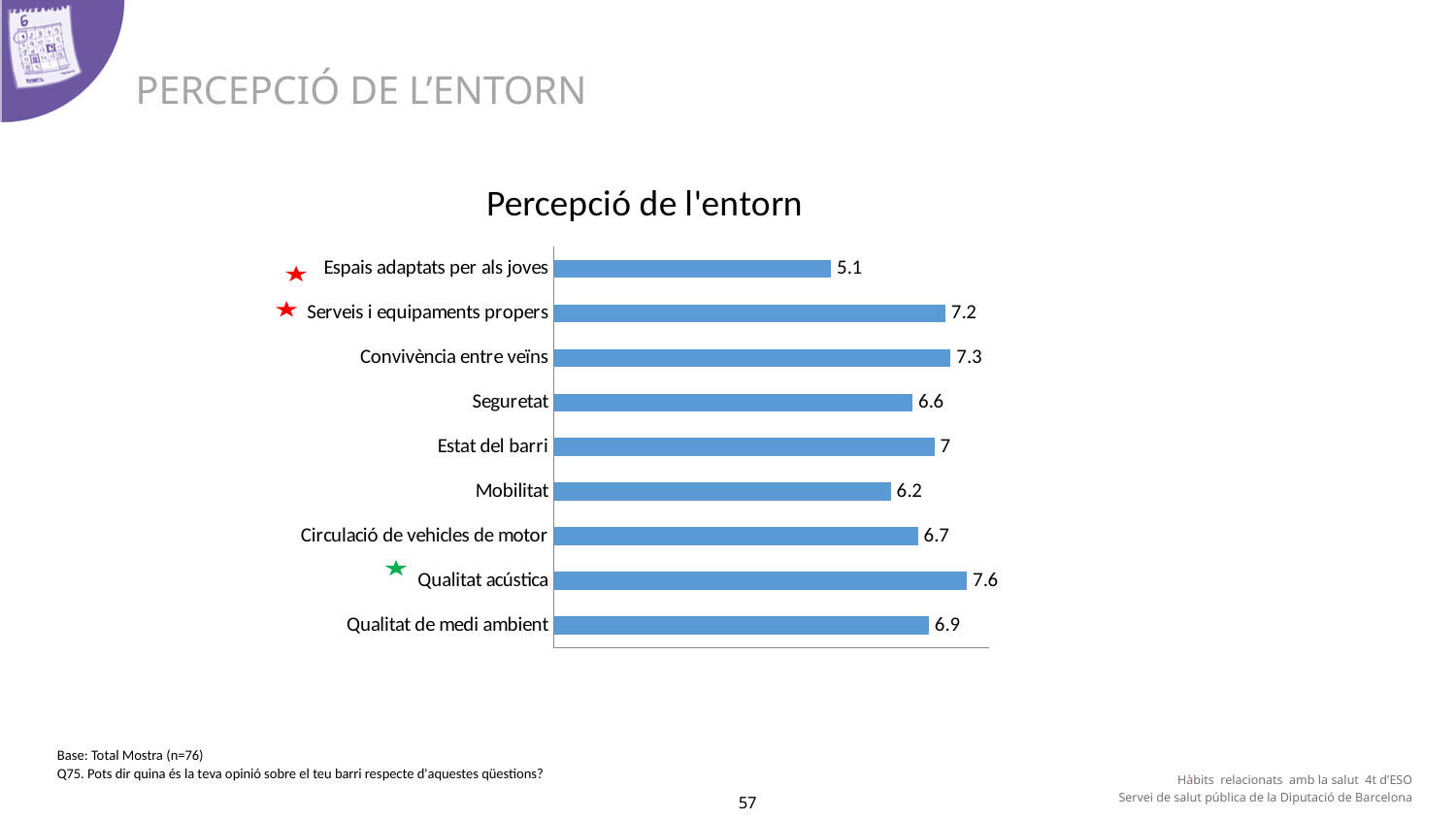
What is the value for Espais adaptats per als joves? 5.1 Which is larger, the value for Serveis i equipaments propers or the value for Qualitat de medi ambient? Serveis i equipaments propers Which category has the highest value? Qualitat acústica What is the value for Mobilitat? 6.2 What is the value for Qualitat acústica? 7.6 Which category has the lowest value? Espais adaptats per als joves What is the difference between the values for Qualitat acústica and Espais adaptats per als joves? 2.5 What is the difference between the values for Convivència entre veïns and Seguretat? 0.7 What kind of chart is shown on the slide? Bar chart What is the value for Estat del barri? 7 How many categories are shown in the chart? 9 What is the title of the chart? Percepció de l'entorn